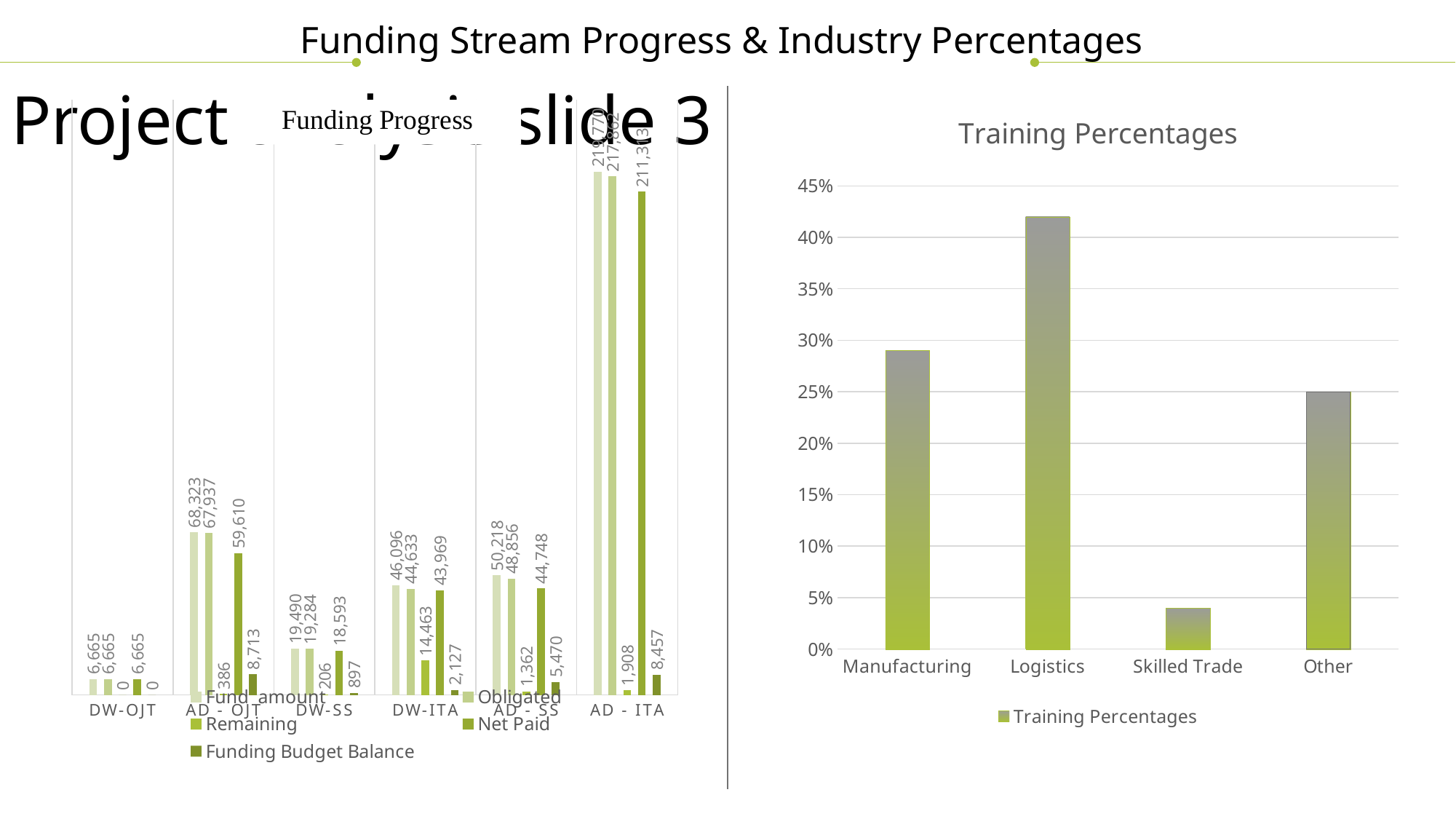
In the Funding Progress chart, what is the Fund_amount value for AD - OJT? 68,323 In the Funding Progress chart, which category has the highest Fund_amount? AD - ITA In the Funding Progress chart, what is the Remaining value for DW-ITA? 14,463 In the Training Percentages chart, which industry has the highest percentage? Logistics In the Training Percentages chart, is the value for Manufacturing greater or less than 25%? greater In the Funding Progress chart, what is the Net Paid value for DW-SS? 18,593 In the Funding Progress chart, what is the Funding Budget Balance for AD - SS? 5,470 In the Funding Progress chart, what is the difference between Fund_amount and Obligated for DW-SS? 206 In the Training Percentages chart, which industry has the lowest percentage? Skilled Trade In the Funding Progress chart, how many series does the legend list? 5 What kind of chart is the Training Percentages chart? bar chart In the Funding Progress chart, is the Net Paid value for AD - OJT larger or smaller than the Net Paid value for AD - SS? larger